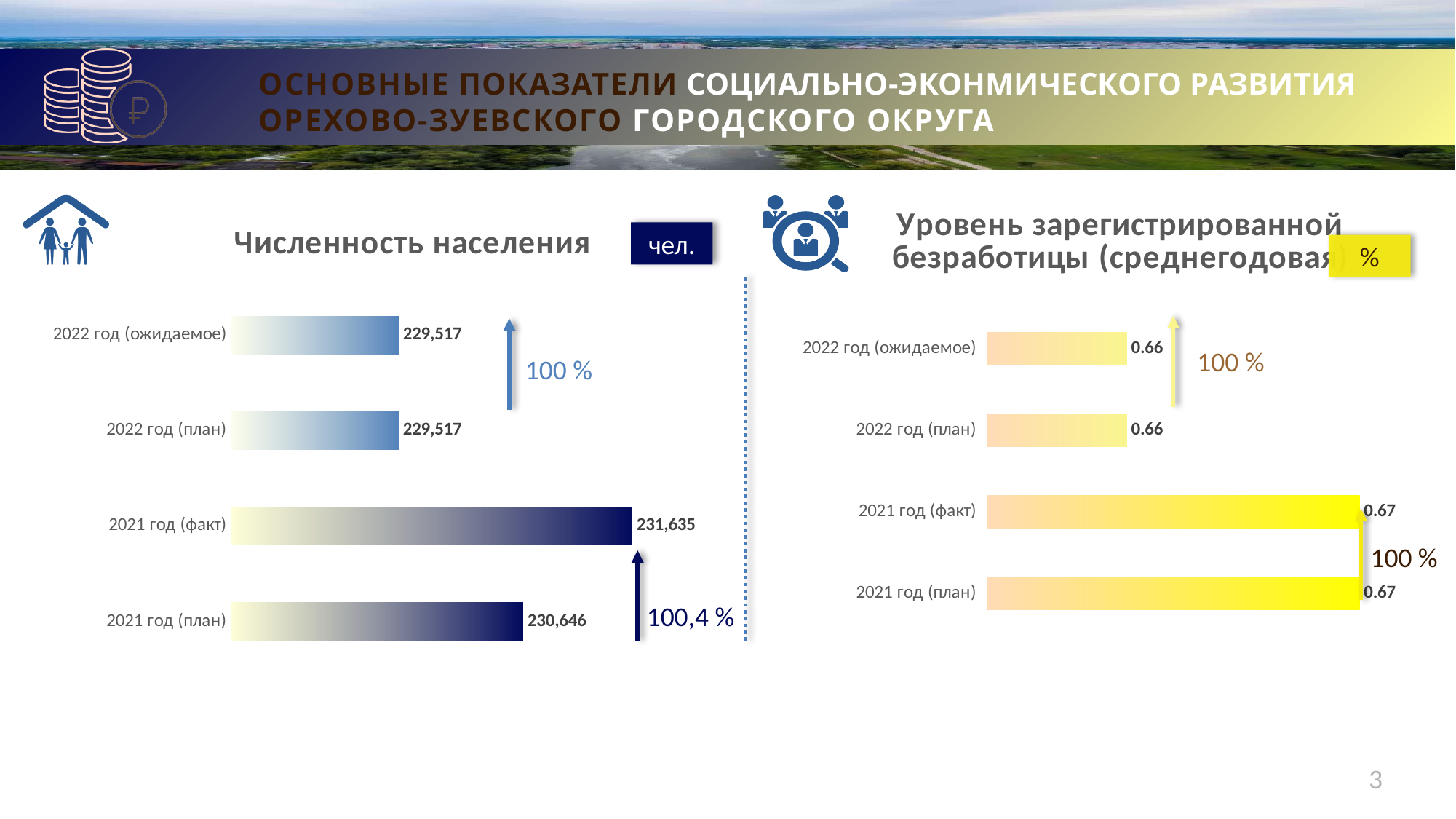
In the "Численность населения" chart, which category has the highest value? 2021 год (факт) In the "Численность населения" chart, what is the value for 2021 год (факт)? 231,635 In the "Уровень зарегистрированной безработицы (среднегодовая)" chart, which is larger: 2021 год (план) or 2022 год (ожидаемое)? 2021 год (план) What type of chart is the "Численность населения" chart? Bar chart In the "Уровень зарегистрированной безработицы (среднегодовая)" chart, what is the value for 2021 год (факт)? 0.67 In the "Численность населения" chart, what is the difference between 2021 год (факт) and 2021 год (план)? 989 In the "Уровень зарегистрированной безработицы (среднегодовая)" chart, what is the value for 2022 год (план)? 0.66 In the "Уровень зарегистрированной безработицы (среднегодовая)" chart, what is the difference between 2021 год (факт) and 2022 год (ожидаемое)? 0.01 In the "Численность населения" chart, what is the value for 2021 год (план)? 230,646 In the "Численность населения" chart, how many bars are shown? 4 What unit is shown in the box next to the title of the "Численность населения" chart? чел. In the "Численность населения" chart, what is the value for 2022 год (ожидаемое)? 229,517